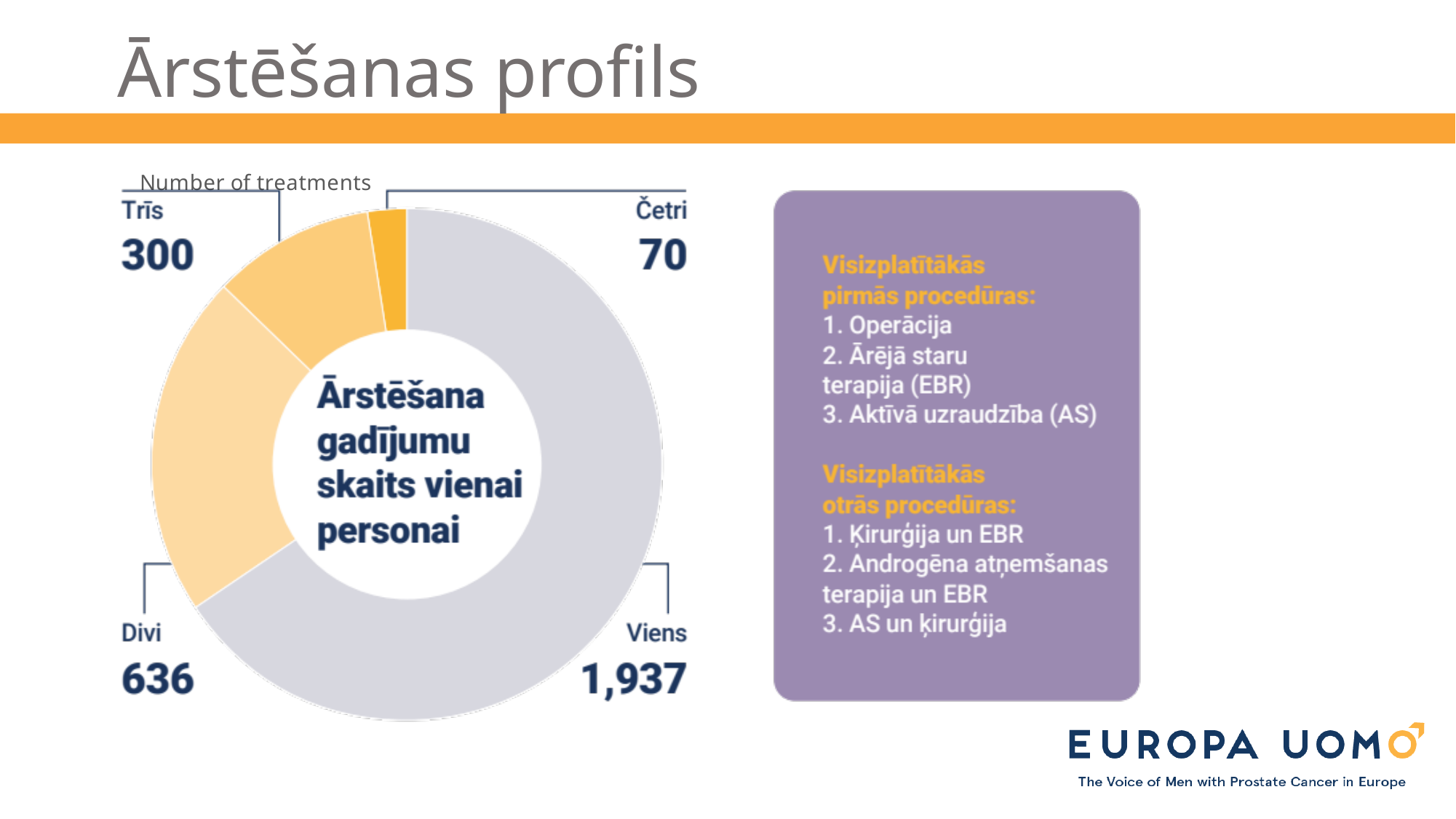
Which is larger, the value for 'Divi' or the value for 'Trīs'? Divi What is the value for the 'Trīs' segment of the chart? 300 What is the value for the 'Četri' segment of the chart? 70 Which category has the largest value in the chart? Viens What is the value for the 'Divi' segment of the chart? 636 What is the difference between the values for 'Viens' and 'Divi'? 1,301 What is the difference between the values for 'Trīs' and 'Četri'? 230 What text is written in the centre of the donut chart? Ārstēšana gadījumu skaits vienai personai Which category has the smallest value in the chart? Četri What is the value for the 'Viens' segment of the chart? 1,937 How many segments does the chart have? 4 What kind of chart is shown on the slide? Pie chart (donut)